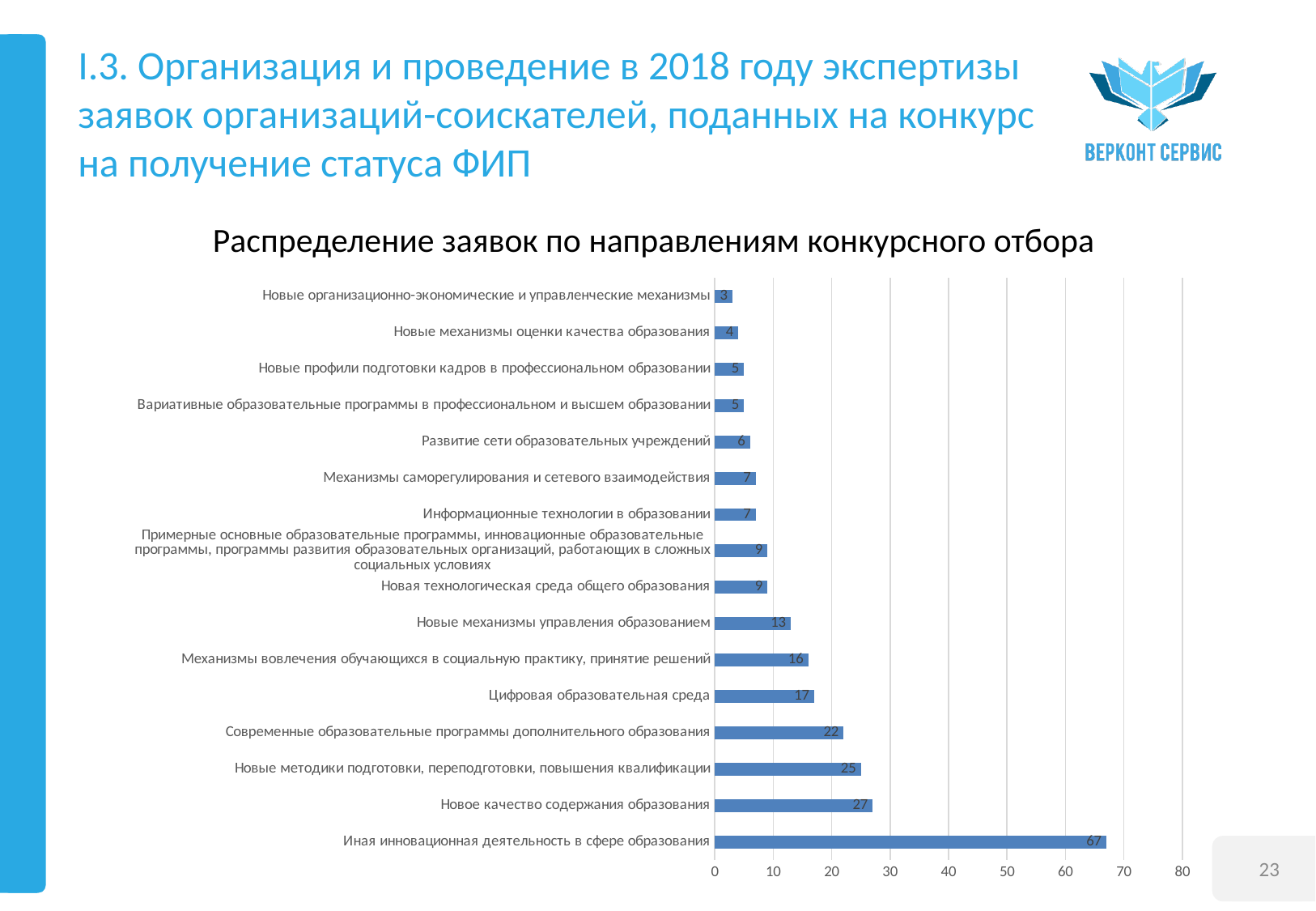
What value is shown for "Иная инновационная деятельность в сфере образования"? 67 Which category has the highest value? Иная инновационная деятельность в сфере образования What is the title of the chart? Распределение заявок по направлениям конкурсного отбора What is the difference between the values for "Новое качество содержания образования" and "Новые методики подготовки, переподготовки, повышения квалификации"? 2 Which category has the lowest value? Новые организационно-экономические и управленческие механизмы What kind of chart is shown on the slide? Bar chart What value is shown for "Развитие сети образовательных учреждений"? 6 Which is larger: the value for "Современные образовательные программы дополнительного образования" or for "Механизмы вовлечения обучающихся в социальную практику, принятие решений"? Современные образовательные программы дополнительного образования What value is shown for "Цифровая образовательная среда"? 17 How many categories are shown in the chart? 16 What is the difference between the values for "Иная инновационная деятельность в сфере образования" and "Новое качество содержания образования"? 40 What value is shown for "Новые механизмы управления образованием"? 13